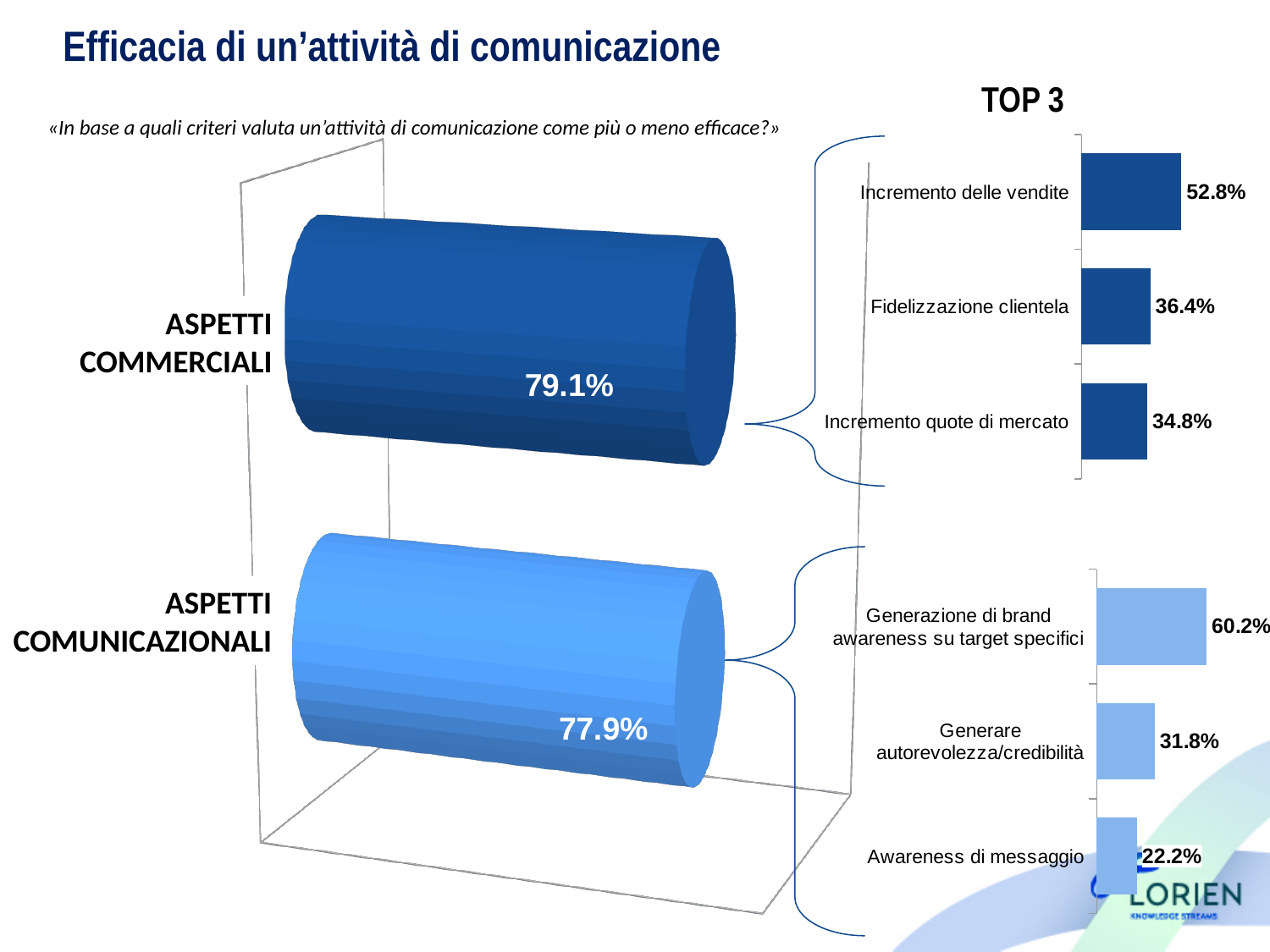
What kind of chart is the lower TOP 3 chart on the right? Bar chart In the upper TOP 3 chart on the right, what is the value for Incremento delle vendite? 52.8% In the upper TOP 3 chart on the right, what is the difference between Incremento delle vendite and Incremento quote di mercato? 18.0% In the lower TOP 3 chart on the right, what is the value for Awareness di messaggio? 22.2% In the large chart on the left, what is the value for ASPETTI COMUNICAZIONALI? 77.9% In the large chart on the left, what is the difference between the values for ASPETTI COMMERCIALI and ASPETTI COMUNICAZIONALI? 1.2% In the upper TOP 3 chart on the right, what is the value for Fidelizzazione clientela? 36.4% In the large chart on the left, how many categories are plotted? 2 In the lower TOP 3 chart on the right, which is larger: Generare autorevolezza/credibilità or Awareness di messaggio? Generare autorevolezza/credibilità In the lower TOP 3 chart on the right, what is the value for Generazione di brand awareness su target specifici? 60.2% In the large chart on the left, what is the value for ASPETTI COMMERCIALI? 79.1% In the upper TOP 3 chart on the right, which category has the lowest value? Incremento quote di mercato